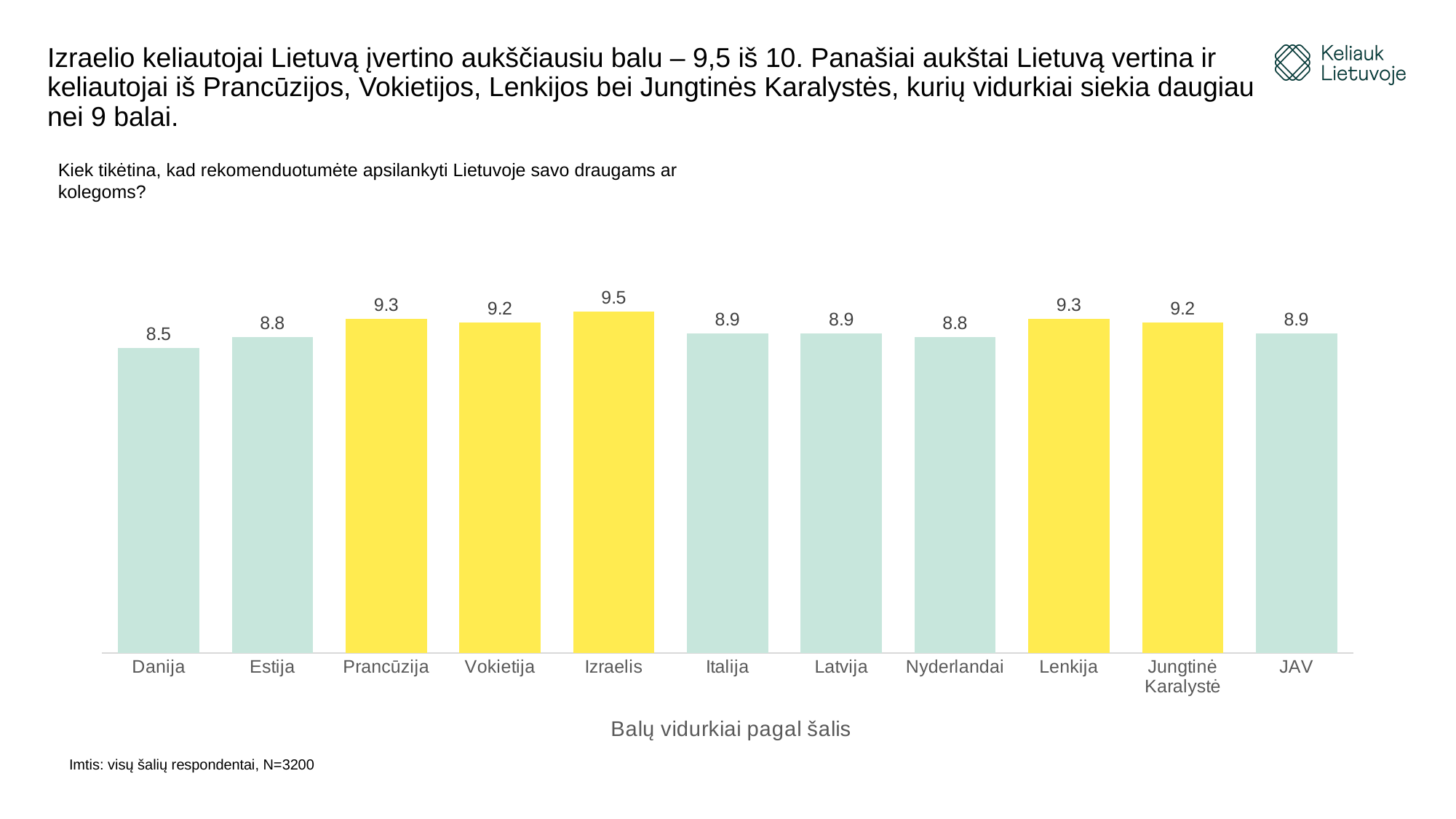
How many bars are highlighted in yellow? 5 Which country has the lowest value? Danija What is the value for Jungtinė Karalystė? 9.2 What is the difference between the values for Lenkija and Latvija? 0.4 What is the value for Izraelis? 9.5 What is the value for Danija? 8.5 What is the difference between the values for Izraelis and Danija? 1.0 What kind of chart is this? bar chart How many countries are shown on the chart? 11 Which is larger, the value for Prancūzija or the value for Italija? Prancūzija What is the x-axis title of the chart? Balų vidurkiai pagal šalis Which country has the highest value? Izraelis